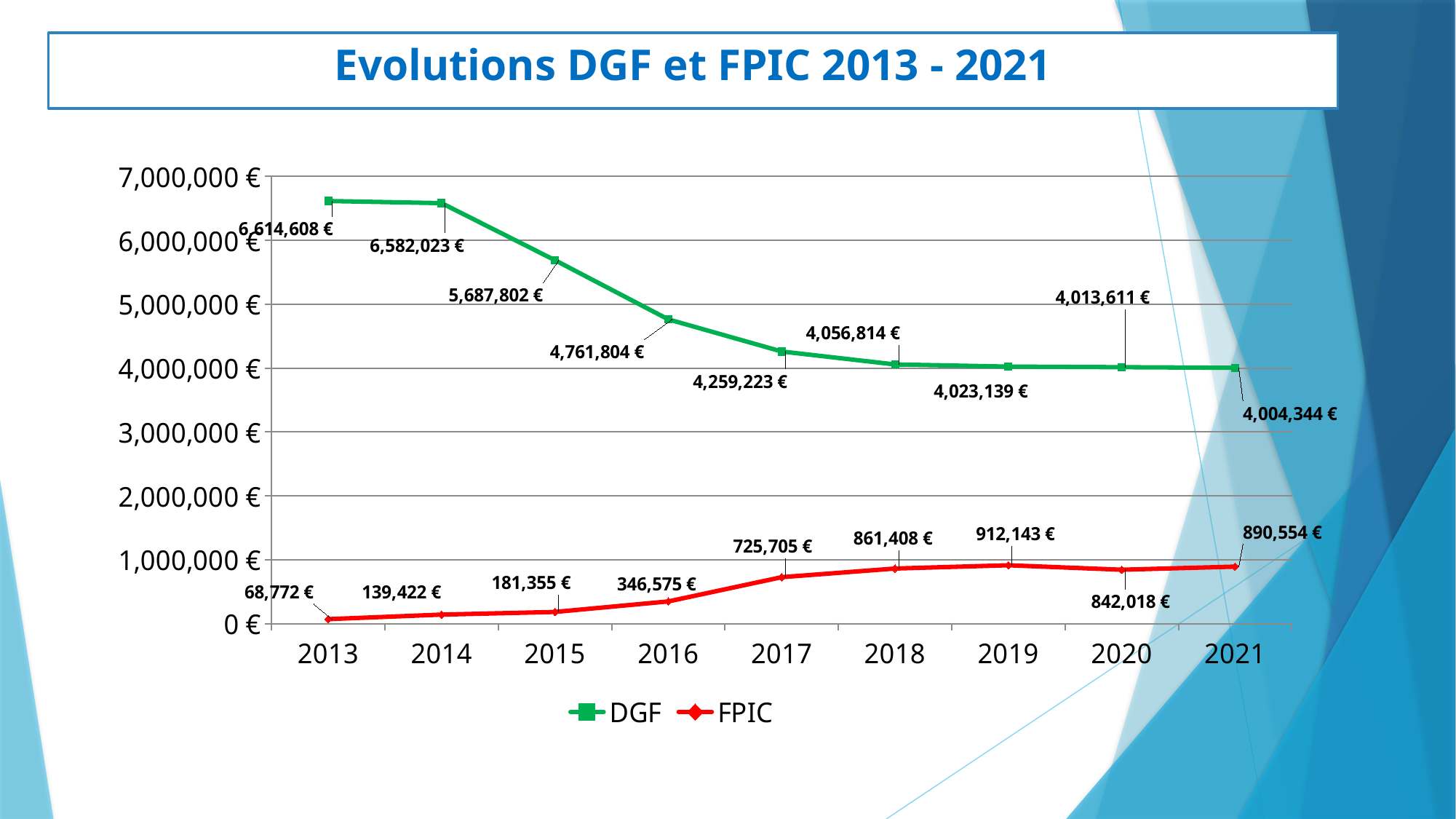
What is the FPIC value for 2017? 725,705 € What is the DGF value for 2021? 4,004,344 € What is the difference between the DGF value in 2013 and the DGF value in 2021? 2,610,264 € What is the DGF value for 2013? 6,614,608 € How many years are shown on the x axis? 9 How many series does the legend list? 2 Which is larger, the FPIC value in 2018 or the FPIC value in 2020? 2018 Is the DGF value for 2016 greater or less than 5,000,000 €? less In which year is the FPIC value highest? 2019 What is the difference between the FPIC value in 2019 and the FPIC value in 2013? 843,371 € In which year is the DGF value lowest? 2021 What kind of chart is shown on the slide? line chart